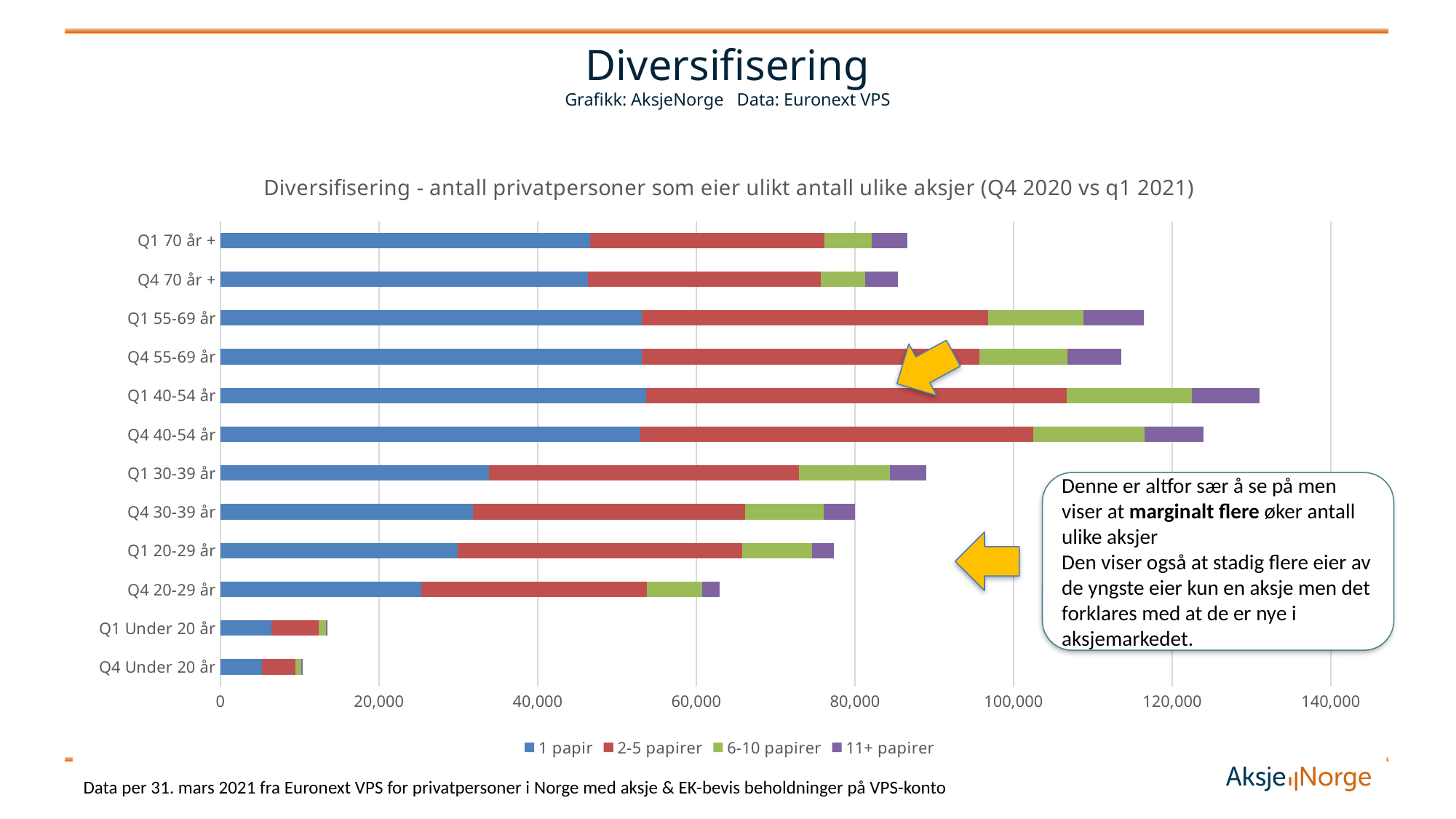
Is the total bar length for Q4 40-54 år greater or less than 100,000? greater How many categories (bars) are shown on the y axis? 12 Which legend entry is shown in blue? 1 papir What kind of chart is shown on the slide? Stacked bar chart Which has the longer total bar, Q1 20-29 år or Q4 20-29 år? Q1 20-29 år How many series does the legend list? 4 Is the total bar length for Q1 Under 20 år greater or less than 20,000? less Which category has the longest total bar? Q1 40-54 år Is the total bar length for Q4 20-29 år greater or less than 80,000? less Which category has the shortest total bar? Q4 Under 20 år Which has the longer total bar, Q1 30-39 år or Q4 30-39 år? Q1 30-39 år